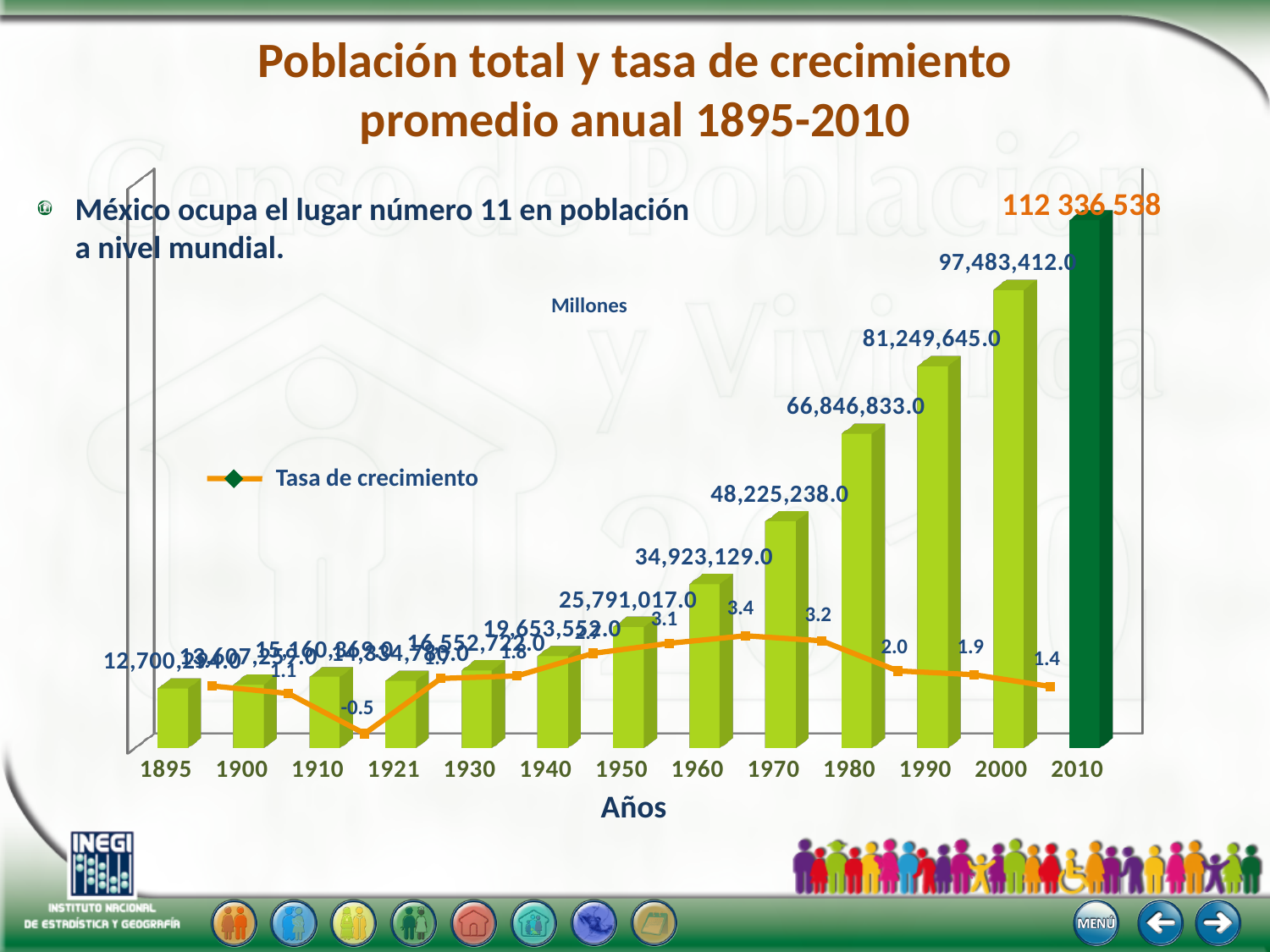
What is the difference between the population in 2000 and in 1990? 16,233,767.0 Which year has the highest total population? 2010 How many years are shown on the x axis? 13 Which year has the lowest total population? 1895 What growth rate (tasa de crecimiento) is labelled near 1921? -0.5 What growth rate (tasa de crecimiento) is labelled near 2010? 1.4 Which is larger, the population in 1960 or in 1950? 1960 What is the total population shown for 2010? 112 336 538 What series name is shown in the legend? Tasa de crecimiento What is the total population shown for 1970? 48,225,238.0 What is the total population shown for 2000? 97,483,412.0 What is the highest growth rate value labelled on the line? 3.4